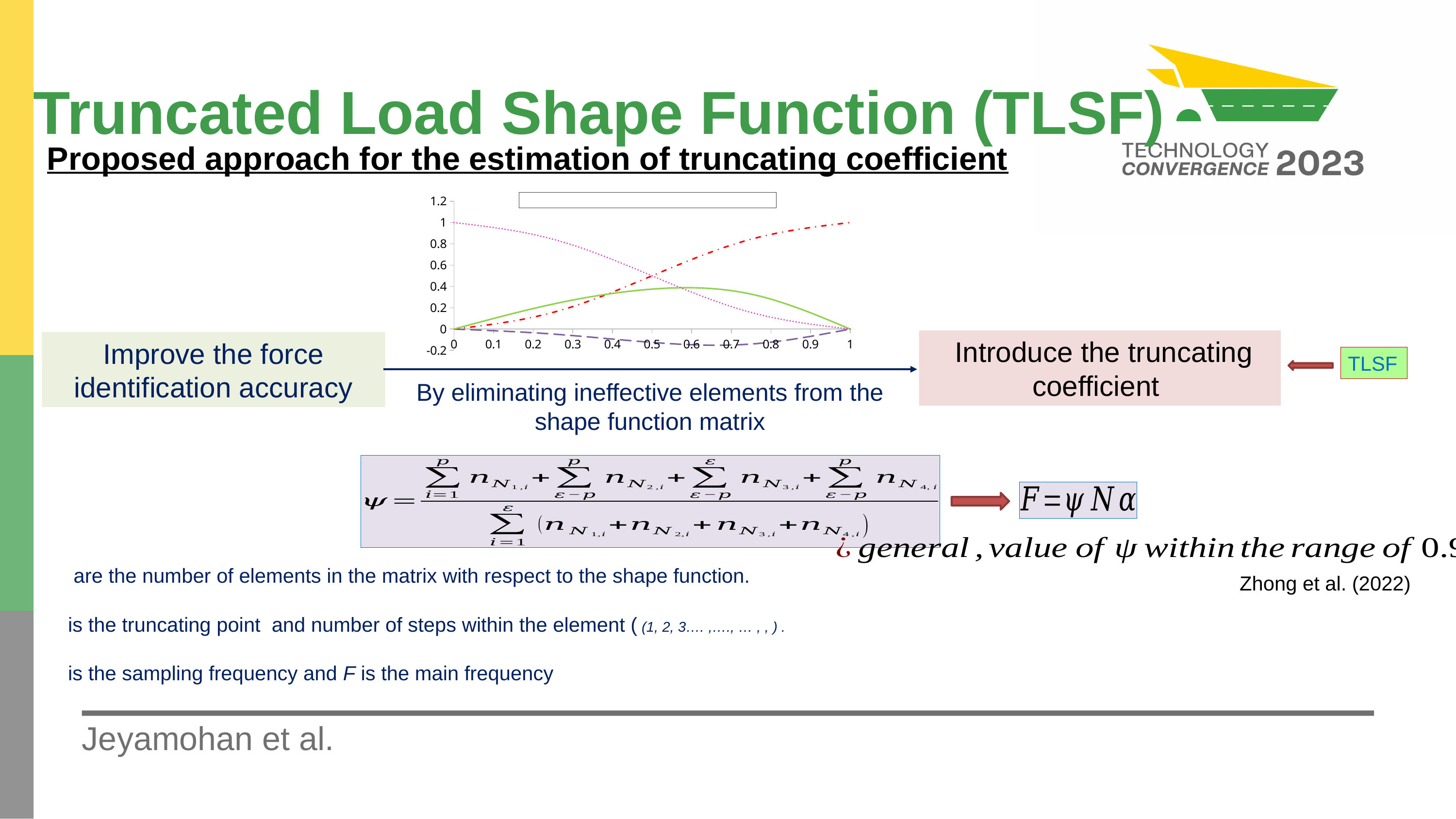
Does the pink dotted line rise or fall as x increases from 0 to 1? fall What kind of chart is shown on the slide? line chart What is the highest value labelled on the y axis? 1.2 Is the peak value of the green solid line greater or less than 0.6? less How many lines are plotted on the chart? 4 Does the red dash-dot line rise or fall as x increases from 0 to 1? rise What is the lowest value labelled on the y axis? -0.2 Is the value of the purple dashed line at x = 0.6 greater or less than 0? less What is the value of the green solid line at x = 0? 0 At x = 0.2, which line has the larger value: the pink dotted line or the red dash-dot line? pink dotted line What is the value of the red dash-dot line at x = 1? 1 What is the value of the pink dotted line at x = 0? 1